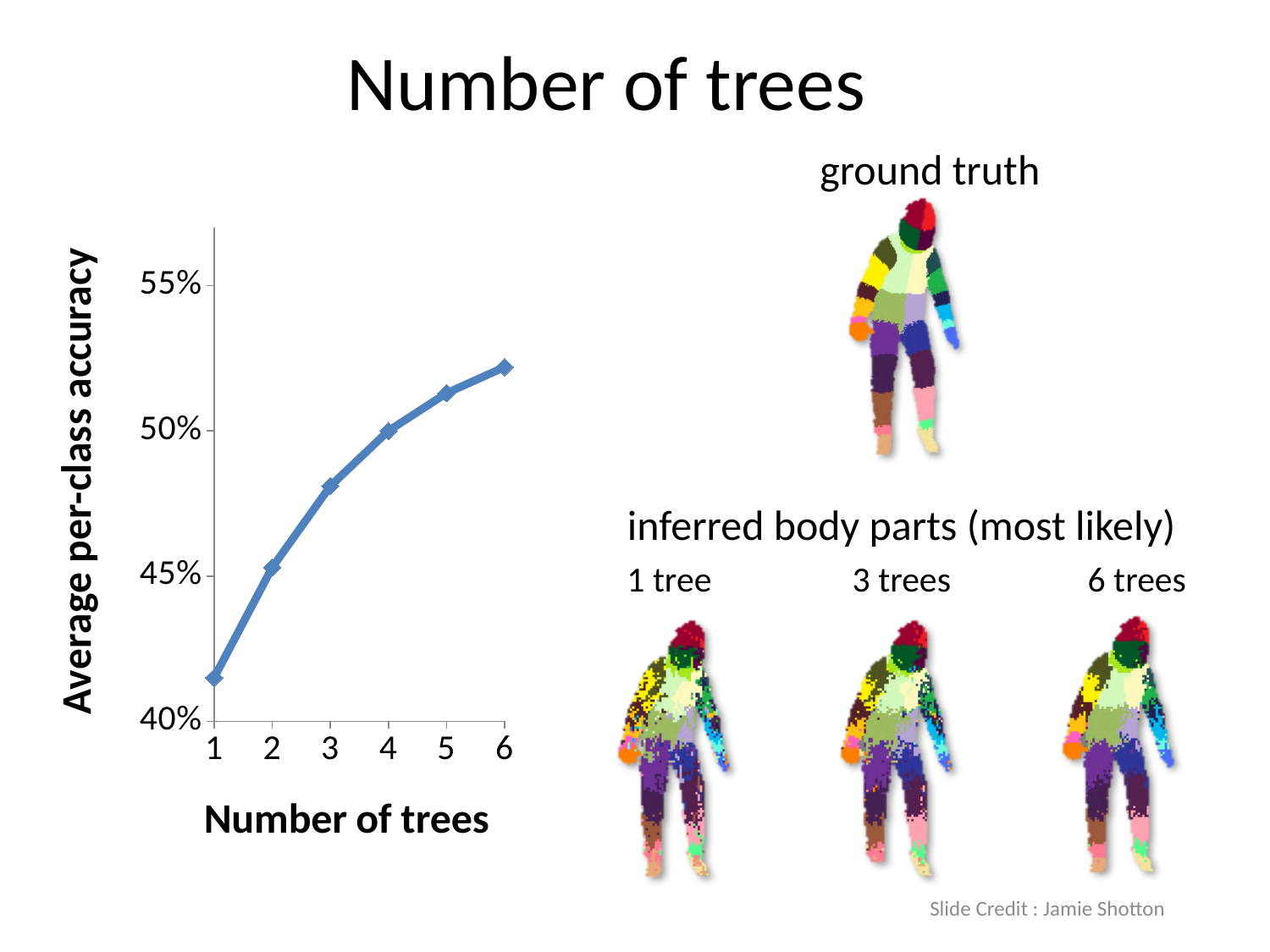
How many data points are plotted on the chart? 6 Which number of trees gives the highest average per-class accuracy? 6 Is the average per-class accuracy for 5 trees greater or less than 50%? greater What kind of chart is shown on the slide? line chart What is the label of the chart's y axis? Average per-class accuracy Is the average per-class accuracy for 6 trees greater or less than 55%? less Is the average per-class accuracy for 3 trees greater or less than 45%? greater Does the average per-class accuracy rise or fall as the number of trees increases? rise Which number of trees gives the lowest average per-class accuracy? 1 Which has a higher average per-class accuracy, 2 trees or 5 trees? 5 trees